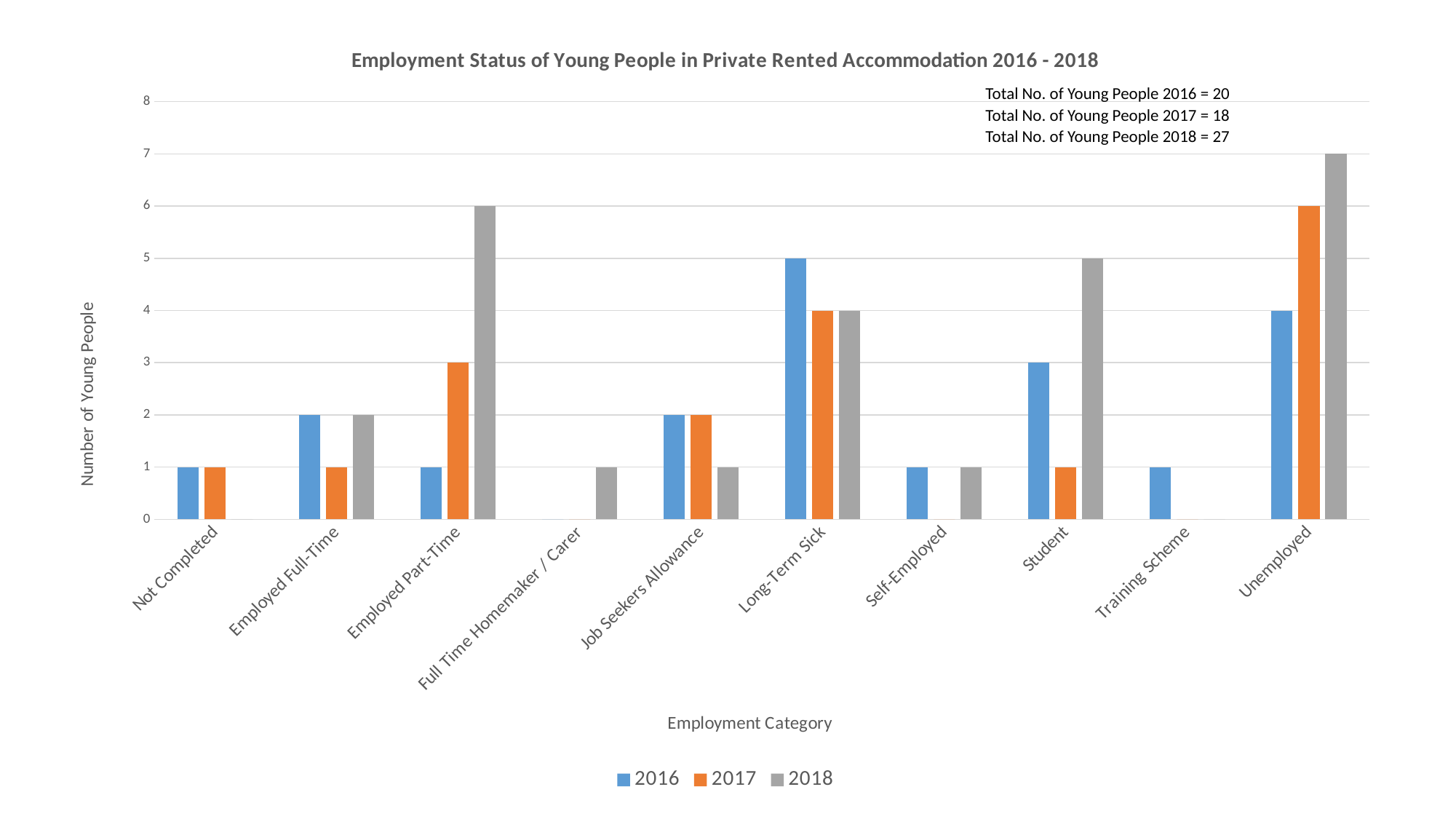
What is the value for Unemployed in 2018? 7 Is the value for Unemployed in 2017 greater or less than 5? greater How many series does the legend list? 3 Which employment category has the highest value for 2016? Long-Term Sick What is the value for Long-Term Sick in 2016? 5 What is the value for Employed Part-Time in 2017? 3 Which is larger for Employed Part-Time: the 2017 value or the 2018 value? 2018 What is the title of the chart? Employment Status of Young People in Private Rented Accommodation 2016 - 2018 How many employment categories are shown on the x axis? 10 What is the difference between the 2018 and 2016 values for Student? 2 Which employment category has the highest value for 2018? Unemployed What type of chart is shown on the slide? bar chart